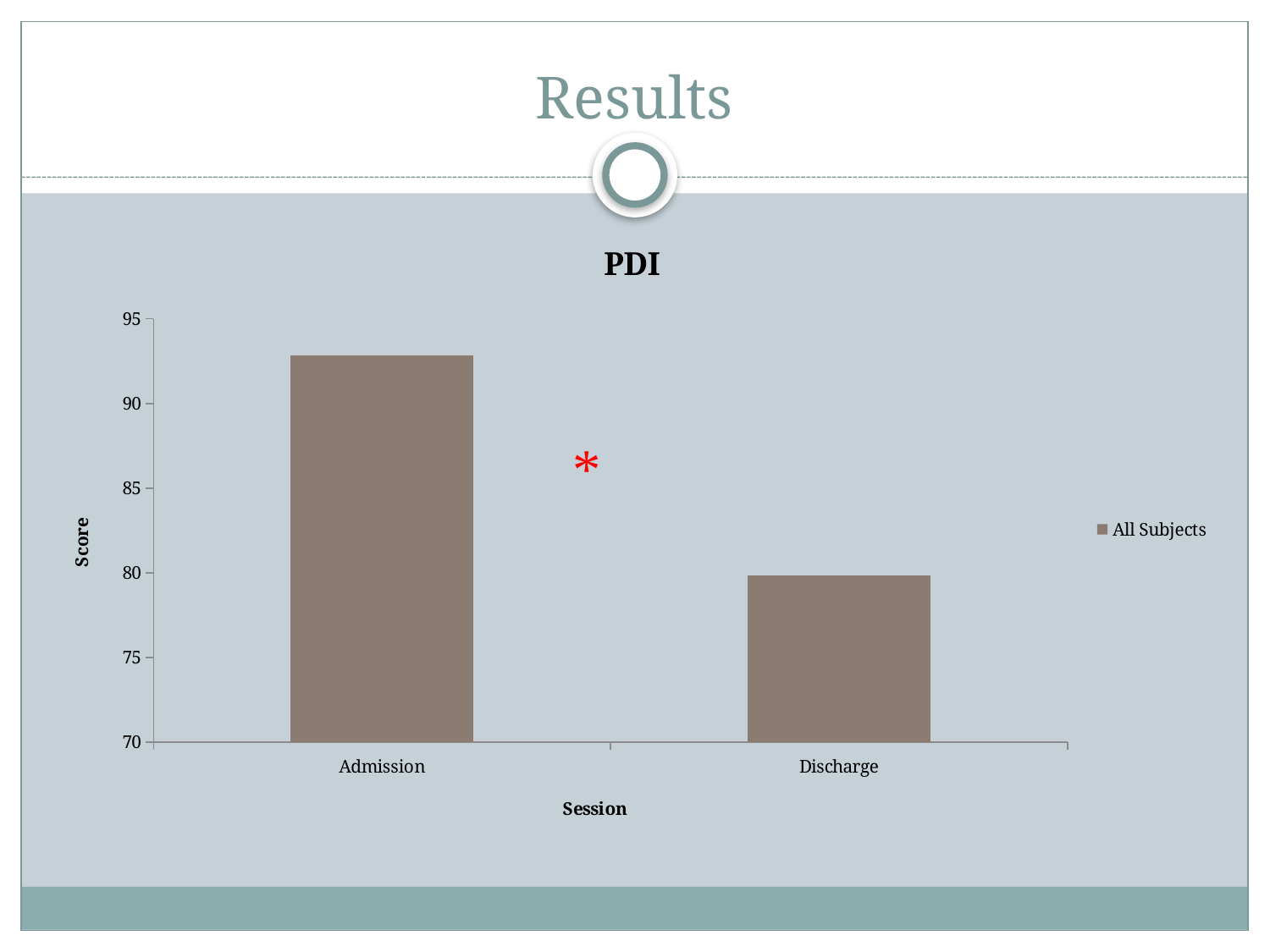
Which session has the highest score? Admission How many categories are shown on the x axis? 2 Which session has the lowest score? Discharge Is the score for Admission greater or less than 90? greater How many series does the legend list? 1 Is the score for Discharge greater or less than 85? less What type of chart is shown on the slide? bar chart Which is larger, the score at Admission or at Discharge? Admission What is the title of the chart? PDI What is the label of the y axis? Score Is the score for Discharge greater or less than 75? greater Do the scores rise or fall from Admission to Discharge? fall